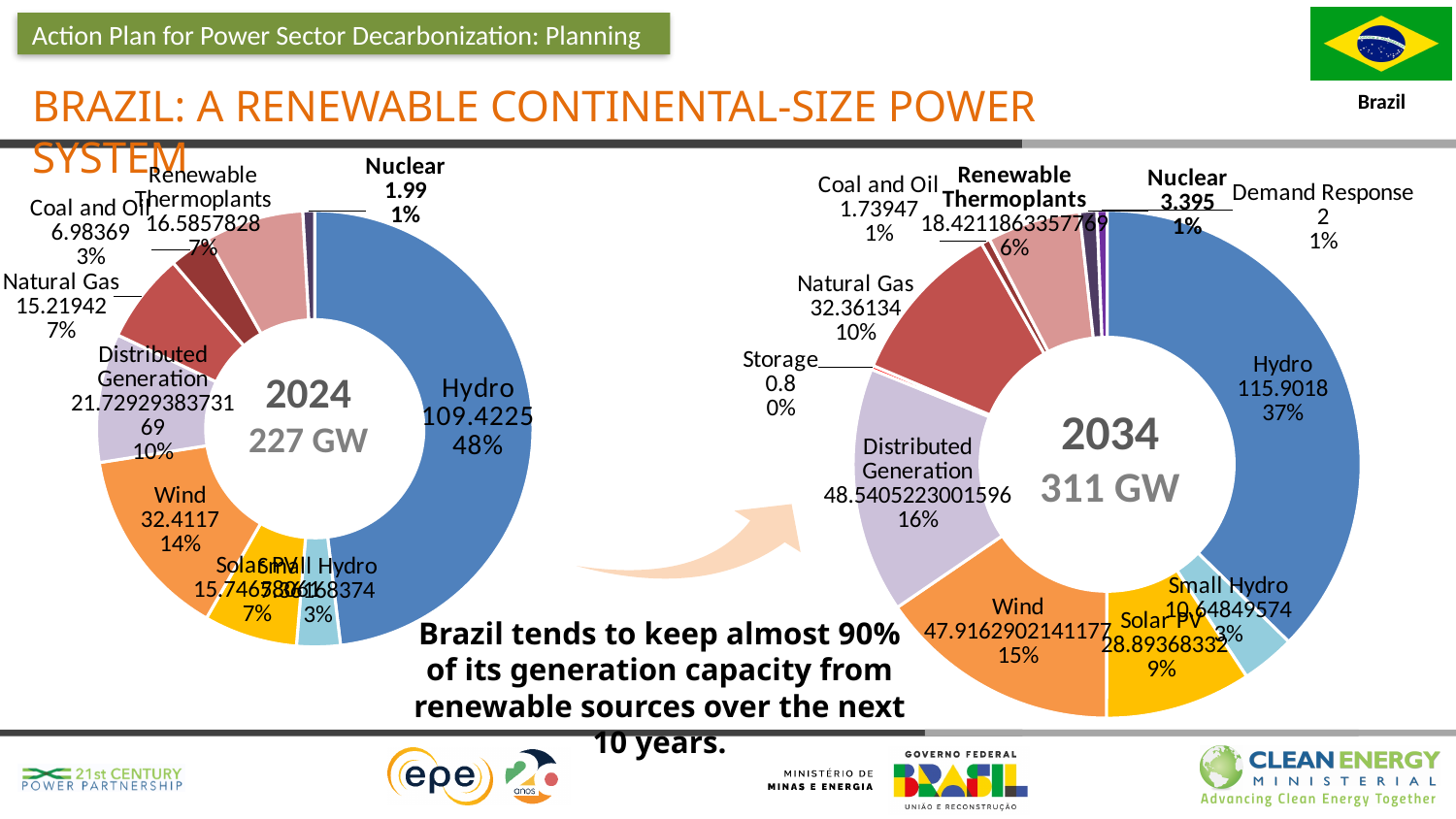
What type of chart is used on this slide? Donut (pie) chart In the 2034 chart, what share does Distributed Generation represent? 16% What total capacity is shown in the centre of the 2034 chart? 311 GW In the 2034 chart, which is larger, Wind or Solar PV? Wind In the 2024 chart, what share of the total does Hydro represent? 48% In the 2024 chart, what is the value for Hydro? 109.4225 In the 2034 chart, what is the value for Natural Gas? 32.36134 In the 2024 chart, what is the value for Coal and Oil? 6.98369 In the 2034 chart, what is the value for Nuclear? 3.395 In the 2024 chart, which category has the smallest slice? Nuclear In the 2034 chart, which category has the largest slice? Hydro What is the difference between the Hydro values in the 2034 chart and the 2024 chart? 6.4793